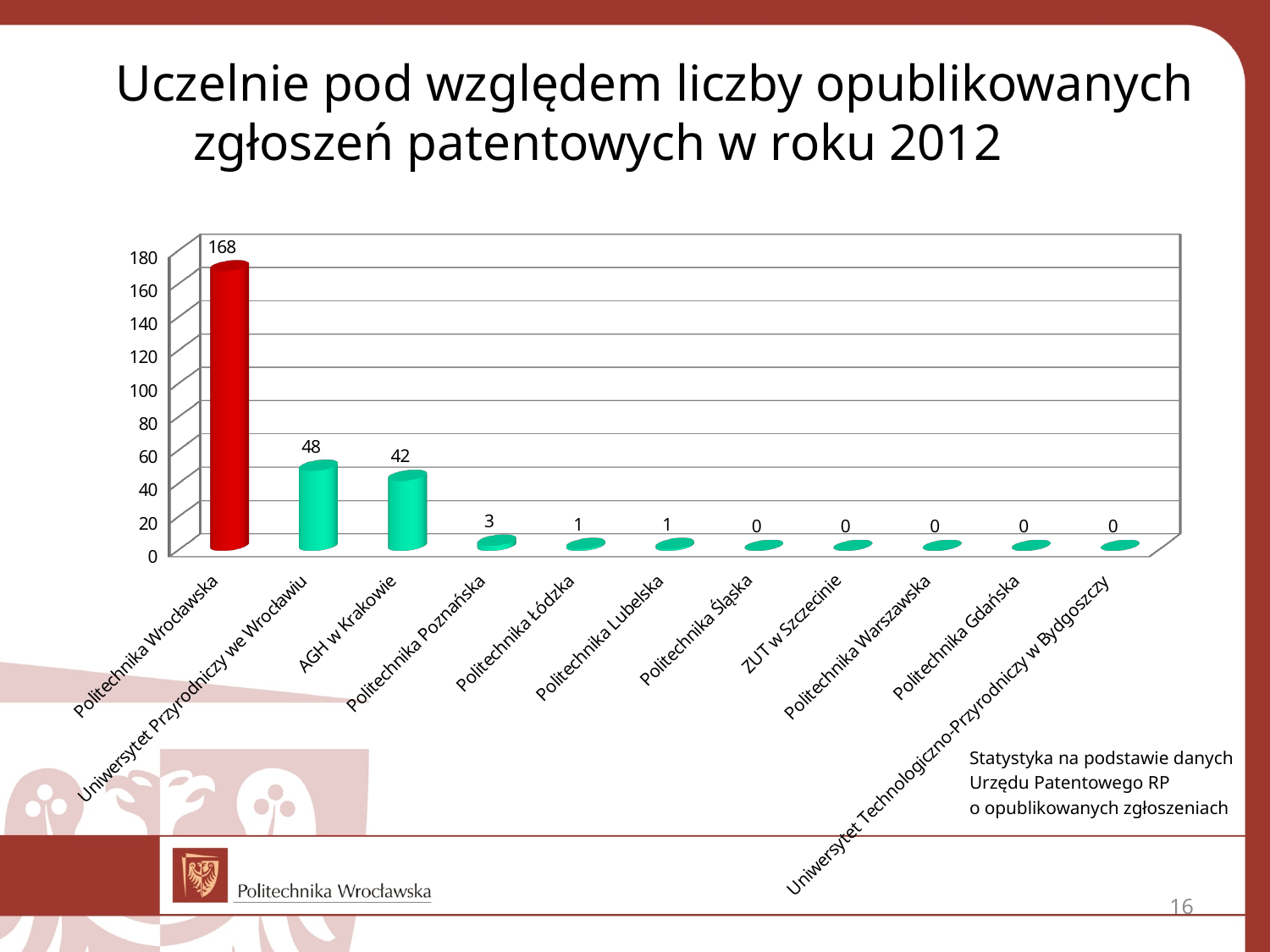
What value is shown for Politechnika Wrocławska? 168 What value is shown for AGH w Krakowie? 42 What value is shown for Politechnika Poznańska? 3 Do the values rise or fall from left to right along the x axis? Fall Which university has the highest number of published patent applications? Politechnika Wrocławska How many universities are shown on the x axis? 11 Which is larger, the value for AGH w Krakowie or the value for Politechnika Poznańska? AGH w Krakowie What is the difference between the values for Politechnika Wrocławska and Uniwersytet Przyrodniczy we Wrocławiu? 120 What kind of chart is shown on the slide? Bar chart What is the difference between the values for Uniwersytet Przyrodniczy we Wrocławiu and AGH w Krakowie? 6 What value is shown for Uniwersytet Przyrodniczy we Wrocławiu? 48 What value is shown for Politechnika Łódzka? 1